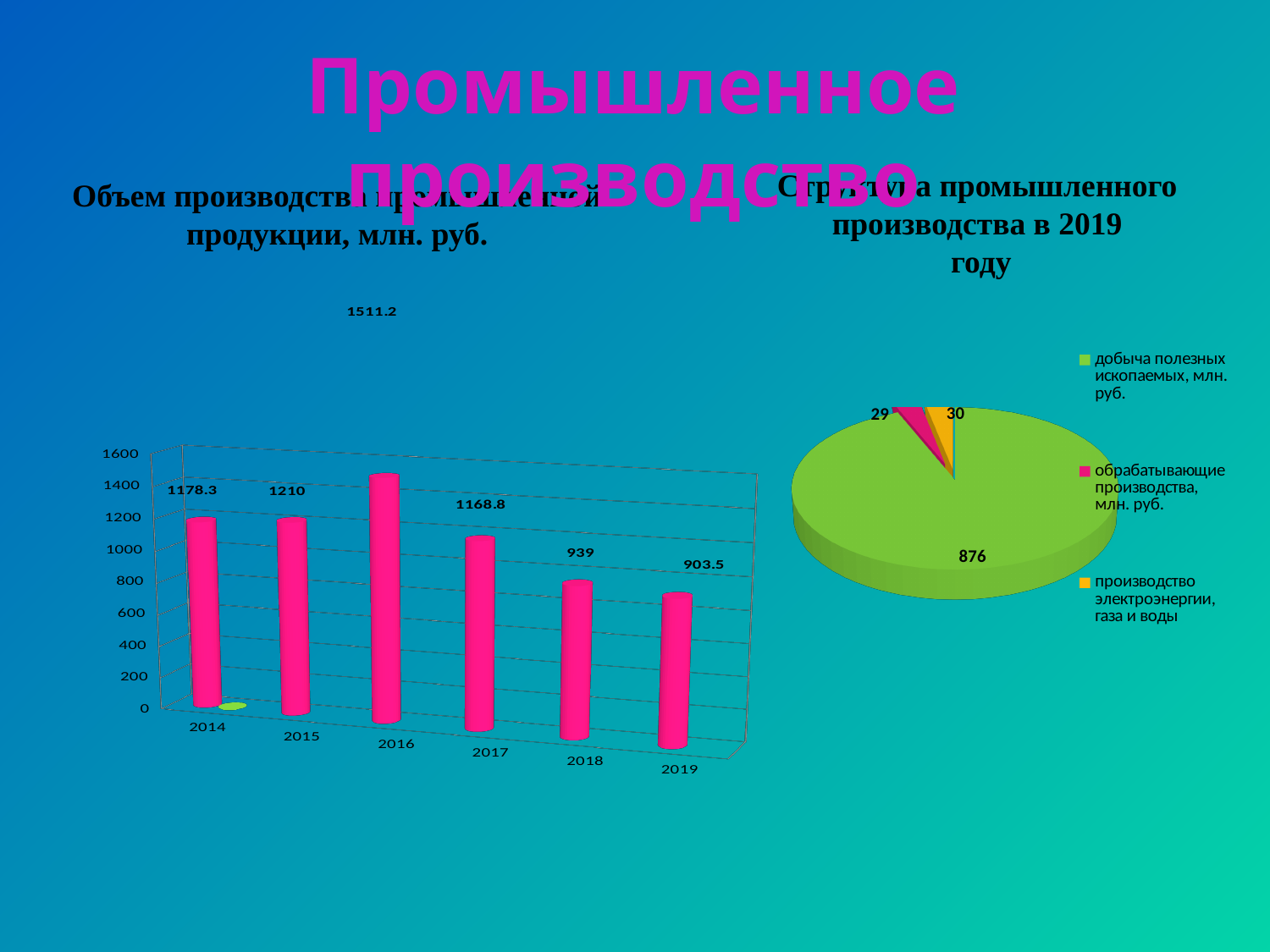
In the bar chart on the left, what is the difference between the values for 2015 and 2014? 31.7 In the bar chart on the left, which year has the lowest value? 2019 In the bar chart 'Объем производства промышленной продукции, млн. руб.', what is the value for 2019? 903.5 In the bar chart on the left, do the values rise or fall from 2016 to 2019? fall In the bar chart on the left, which year has the larger value, 2017 or 2018? 2017 What kind of chart is the chart on the left of the slide? bar chart In the bar chart 'Объем производства промышленной продукции, млн. руб.', what is the value for 2016? 1511.2 In the pie chart 'Структура промышленного производства в 2019 году', what is the value for 'добыча полезных ископаемых, млн. руб.'? 876 How many years are shown in the bar chart on the left? 6 In the bar chart on the left, what is the difference between the values for 2018 and 2019? 35.5 In the bar chart on the left, which year has the highest value? 2016 In the pie chart on the right, which category has the largest slice? добыча полезных ископаемых, млн. руб.